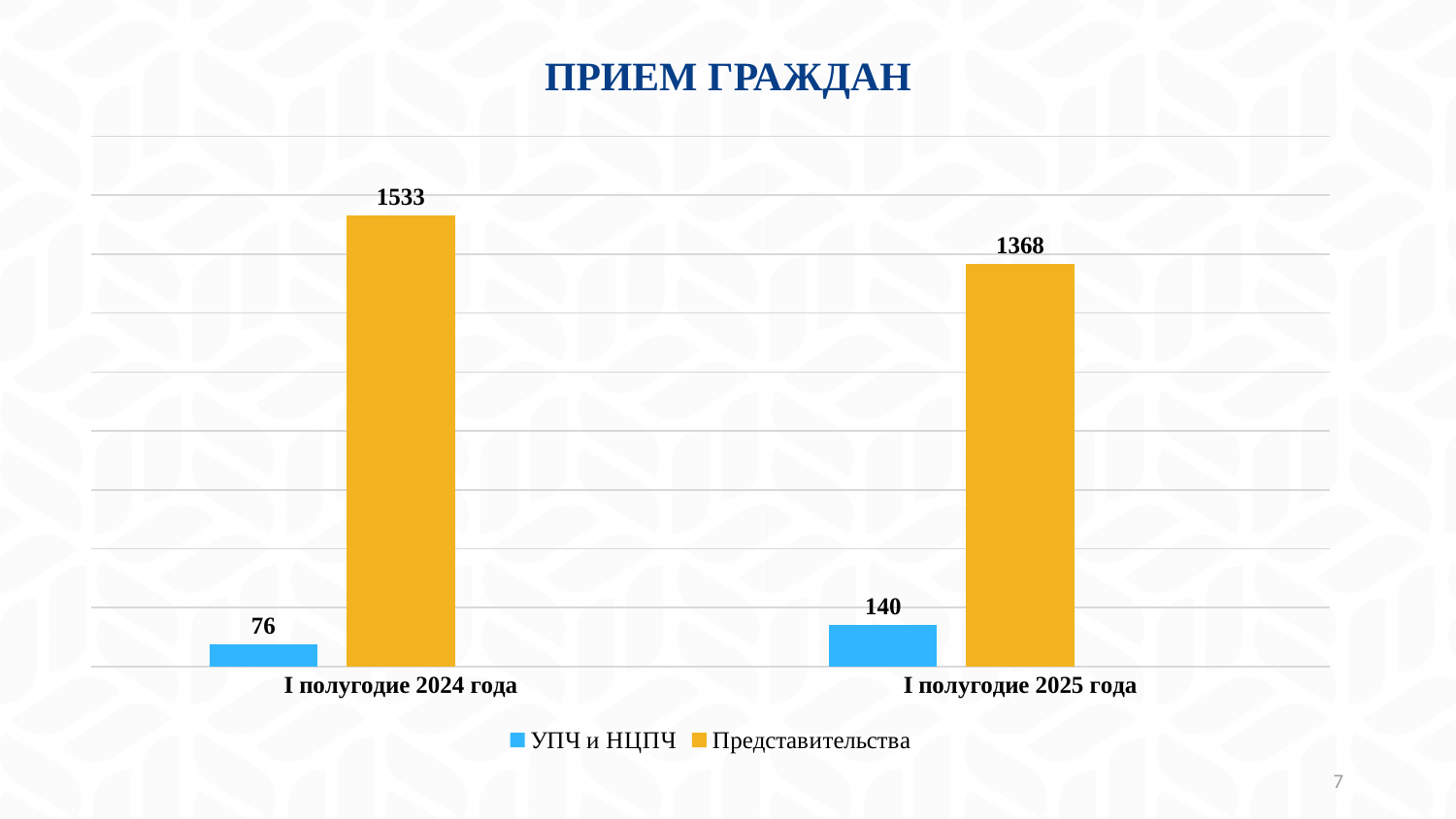
What is the value for УПЧ и НЦПЧ in I полугодие 2025 года? 140 What is the difference between the УПЧ и НЦПЧ values for I полугодие 2025 года and I полугодие 2024 года? 64 What is the value for Представительства in I полугодие 2024 года? 1533 What is the title of the chart? ПРИЕМ ГРАЖДАН What is the difference between the Представительства values for I полугодие 2024 года and I полугодие 2025 года? 165 In which period is the value for УПЧ и НЦПЧ lowest? I полугодие 2024 года Which is larger: УПЧ и НЦПЧ in I полугодие 2025 года or УПЧ и НЦПЧ in I полугодие 2024 года? I полугодие 2025 года In which period is the value for Представительства highest? I полугодие 2024 года What is the value for УПЧ и НЦПЧ in I полугодие 2024 года? 76 What kind of chart is shown on the slide? Bar chart What is the value for Представительства in I полугодие 2025 года? 1368 How many series does the legend list? 2